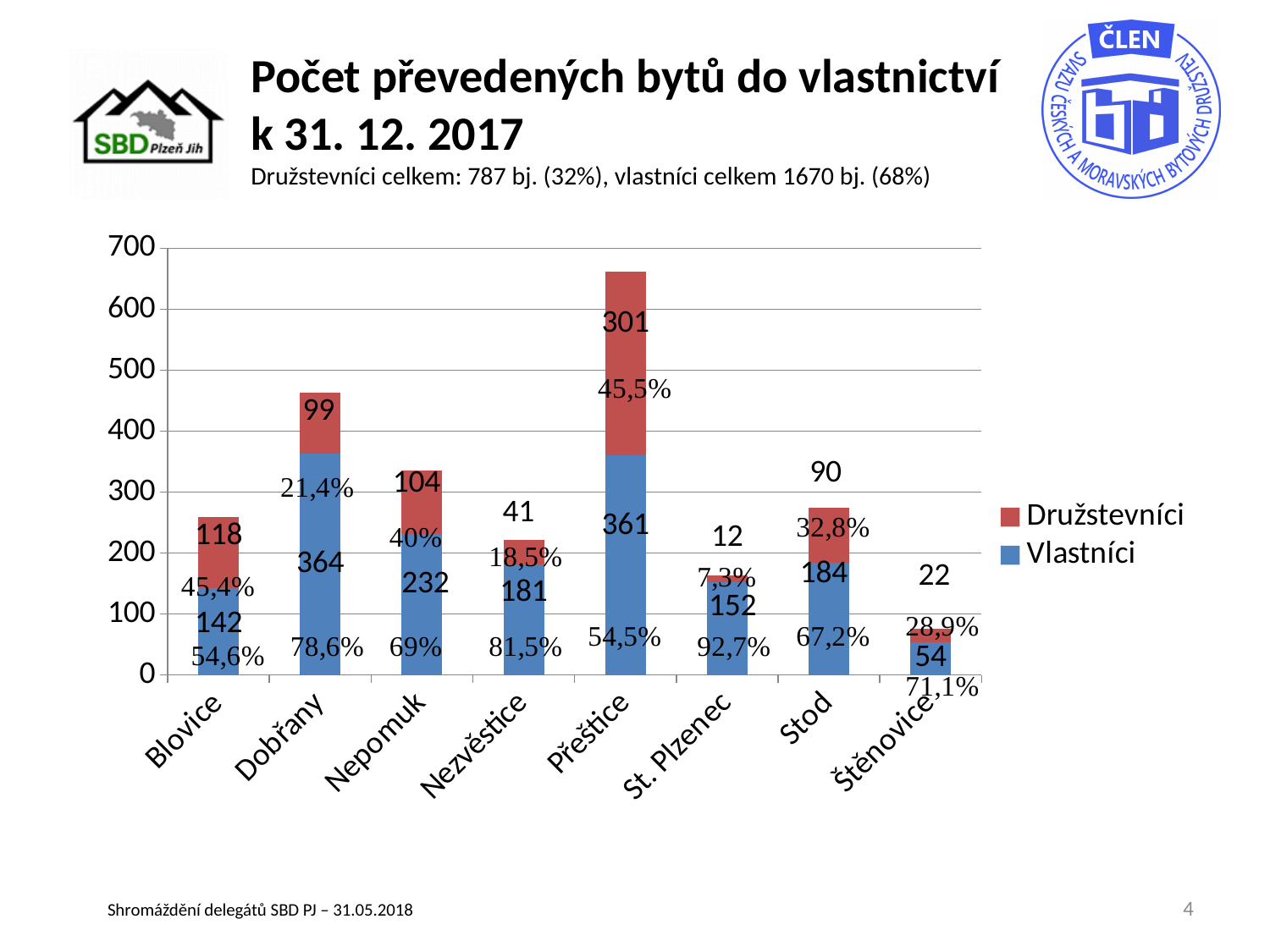
What is the total of the stacked bar for Stod? 274 How many series does the legend list? 2 What is the Družstevníci value for Přeštice? 301 Which town has the highest Družstevníci value? Přeštice What is the Vlastníci value for Dobřany? 364 How many categories (towns) are shown on the x axis? 8 What type of chart is shown on the slide? stacked bar chart What percentage is shown for Vlastníci in St. Plzenec? 92,7% Which town has the lowest Vlastníci value? Štěnovice Which series is shown in red? Družstevníci Which is larger, the Družstevníci value for Blovice or for Nepomuk? Blovice What is the difference between the Vlastníci values for Nepomuk and Nezvěstice? 51